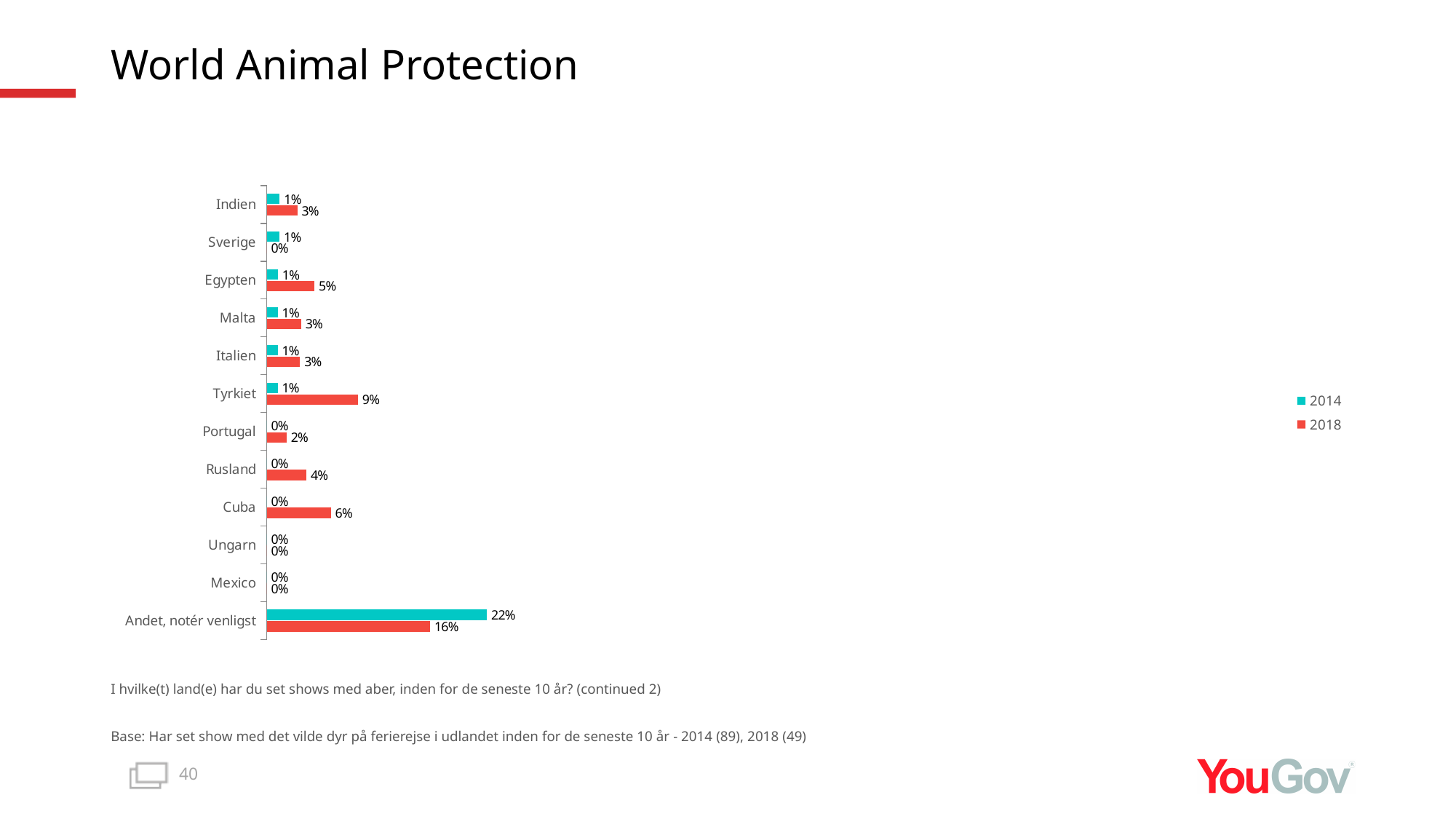
What is the 2018 value for Egypten? 5% Which category has the highest 2018 value? Andet, notér venligst What is the 2018 value for Tyrkiet? 9% What is the 2014 value for Andet, notér venligst? 22% Among the named countries (excluding Andet, notér venligst), which has the highest 2018 value? Tyrkiet What is the 2018 value for Cuba? 6% How many series does the legend list? 2 Which is larger for Cuba: the 2014 value or the 2018 value? 2018 How many categories are shown on the chart? 12 What is the difference between the 2018 values for Tyrkiet and Portugal? 7% What kind of chart is shown on the slide? Bar chart What is the difference between the 2014 and 2018 values for Andet, notér venligst? 6%